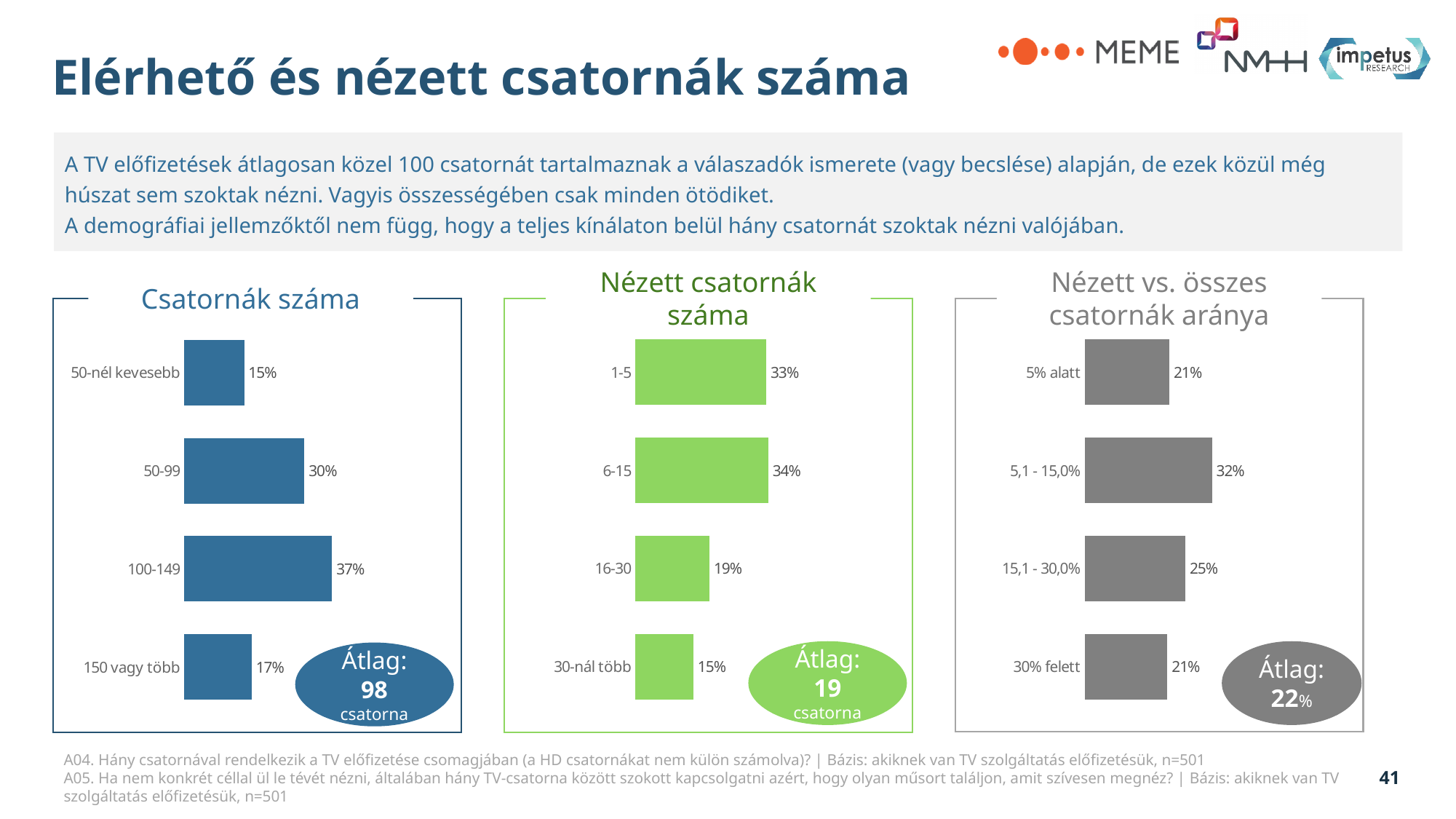
In the 'Nézett vs. összes csatornák aránya' chart, which is larger: '15,1 - 30,0%' or '30% felett'? 15,1 - 30,0% In the 'Csatornák száma' chart, what is the difference between '50-99' and '150 vagy több'? 13% What average value is shown in the 'Nézett csatornák száma' chart? 19 csatorna In the 'Nézett csatornák száma' chart, which category has the highest value? 6-15 In the 'Nézett vs. összes csatornák aránya' chart, what is the value for '5,1 - 15,0%'? 32% In the 'Nézett vs. összes csatornák aránya' chart, what is the difference between '5,1 - 15,0%' and '5% alatt'? 11% In the 'Csatornák száma' chart, what is the value for '100-149'? 37% What average value is shown in the 'Csatornák száma' chart? 98 csatorna In the 'Nézett csatornák száma' chart, how many categories are shown? 4 In the 'Csatornák száma' chart, which category has the lowest value? 50-nél kevesebb In the 'Nézett csatornák száma' chart, what is the value for '16-30'? 19% What kind of chart is the 'Csatornák száma' chart? Bar chart